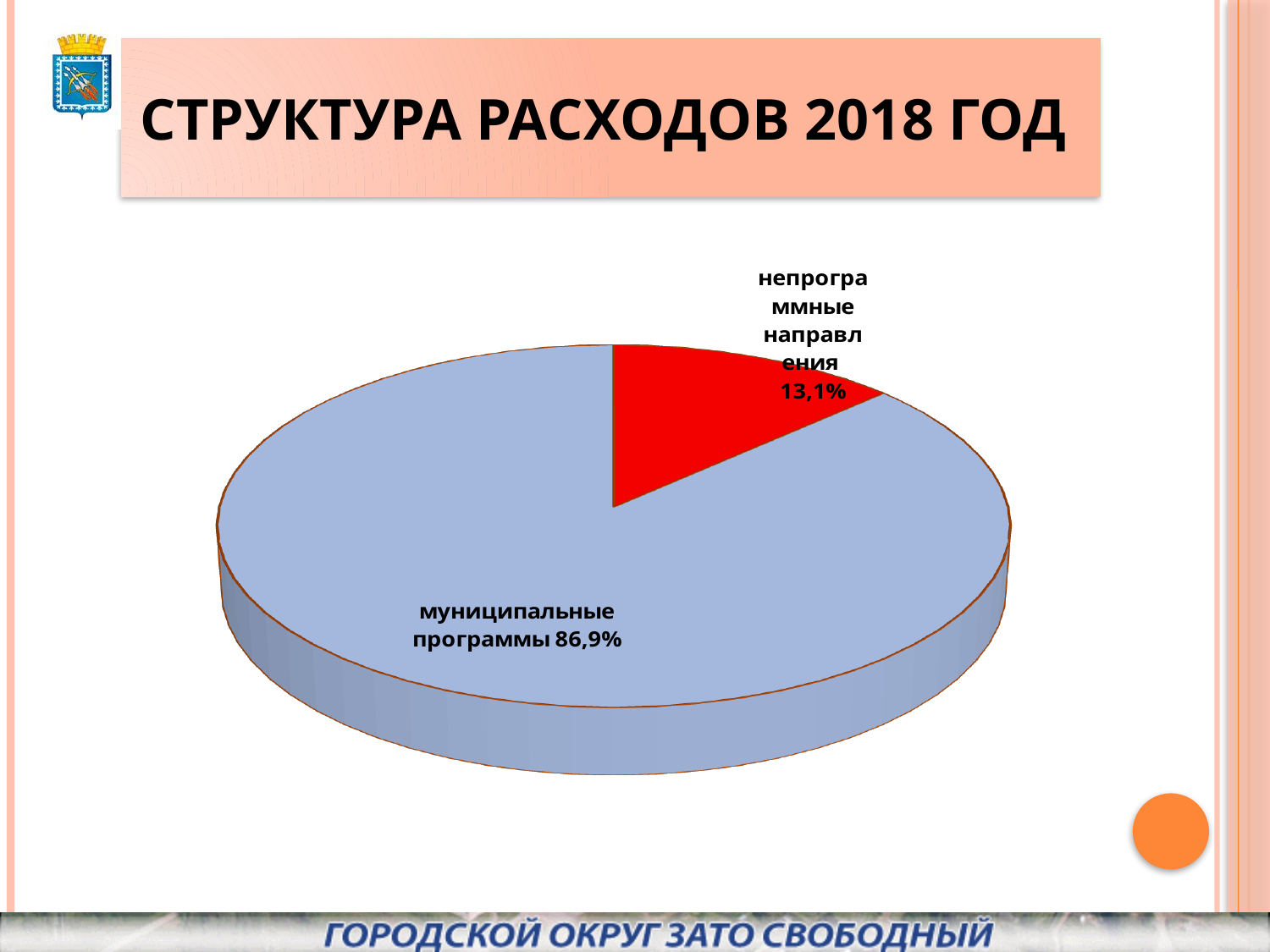
What is the combined share of the two slices in the pie chart? 100% What share of expenditures goes to непрограммные направления? 13,1% What kind of chart is shown on the slide? pie chart What colour is the slice for непрограммные направления? red Which is larger: the share for муниципальные программы or for непрограммные направления? муниципальные программы What share of expenditures goes to муниципальные программы? 86,9% What is the difference in percentage points between муниципальные программы and непрограммные направления? 73,8 Which category has the smallest share of the pie? непрограммные направления What is the title of the slide containing the chart? СТРУКТУРА РАСХОДОВ 2018 ГОД How many slices does the pie chart have? 2 Which category has the largest share of the pie? муниципальные программы